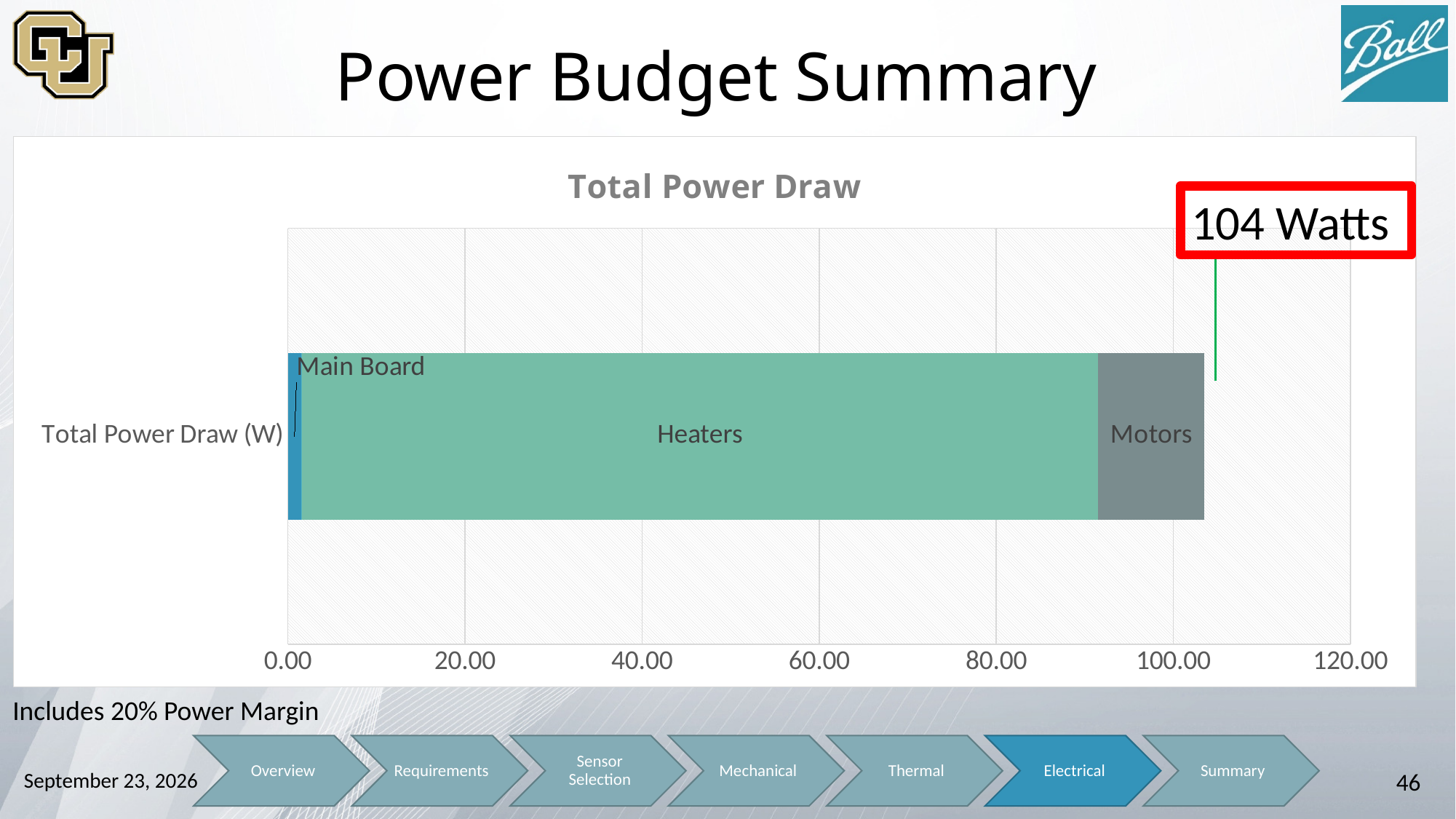
What total power draw is annotated in the red box on the chart? 104 Watts Which segment is larger, Heaters or Motors? Heaters What is the label of the single category on the vertical axis? Total Power Draw (W) Is the width of the Motors segment greater or less than 20? less Which segment is larger, Motors or Main Board? Motors Which segment of the stacked bar is the largest? Heaters Is the total length of the stacked bar greater or less than 120? less What type of chart is shown on the slide? bar chart What is the title of the chart? Total Power Draw Is the width of the Heaters segment greater or less than 80? greater